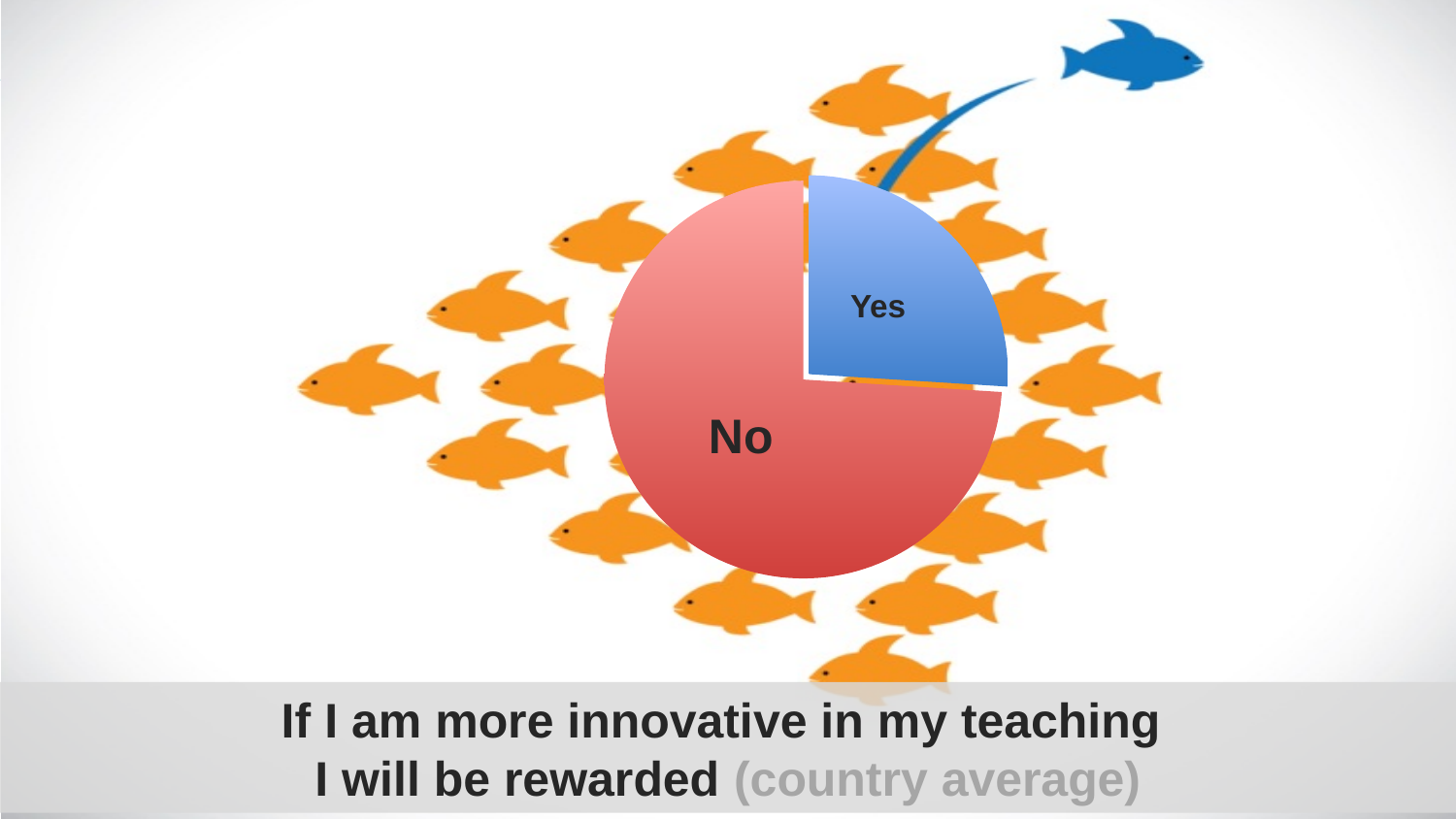
What kind of chart is shown on the slide? pie chart Which slice of the pie chart is the largest? No How many slices does the pie chart have? 2 Which slice is larger in the pie chart, Yes or No? No Which slice of the pie chart is the smallest? Yes What colour is the "Yes" slice of the pie chart? blue What colour is the "No" slice of the pie chart? red What are the labels of the two slices in the pie chart? Yes and No